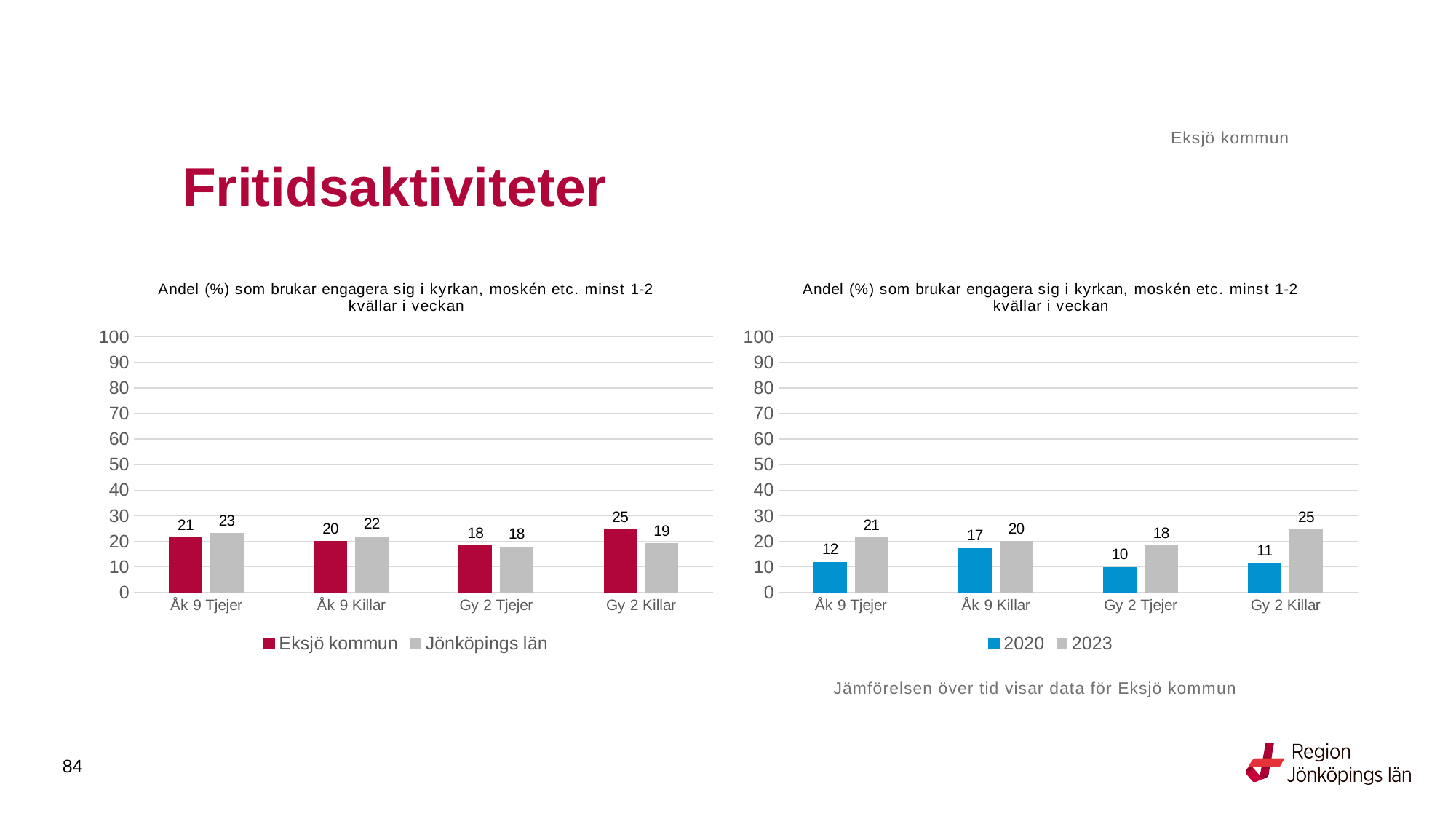
In the right chart, which category has the lowest value for 2020? Gy 2 Tjejer In the left chart, what is the value for Eksjö kommun for Gy 2 Killar? 25 How many series does the legend of the left chart list? 2 In the right chart, what is the value for 2020 for Gy 2 Tjejer? 10 In the right chart, what is the value for 2023 for Åk 9 Killar? 20 What kind of chart is the right chart? Bar chart In the right chart, what is the difference between the 2023 and 2020 values for Gy 2 Killar? 14 How many categories are shown on the x axis of the right chart? 4 In the left chart, what is the value for Jönköpings län for Åk 9 Tjejer? 23 In the left chart, which category has the highest value for Eksjö kommun? Gy 2 Killar In the left chart, what is the difference between the Eksjö kommun and Jönköpings län values for Gy 2 Killar? 6 In the left chart, which is larger for Åk 9 Killar: Eksjö kommun or Jönköpings län? Jönköpings län